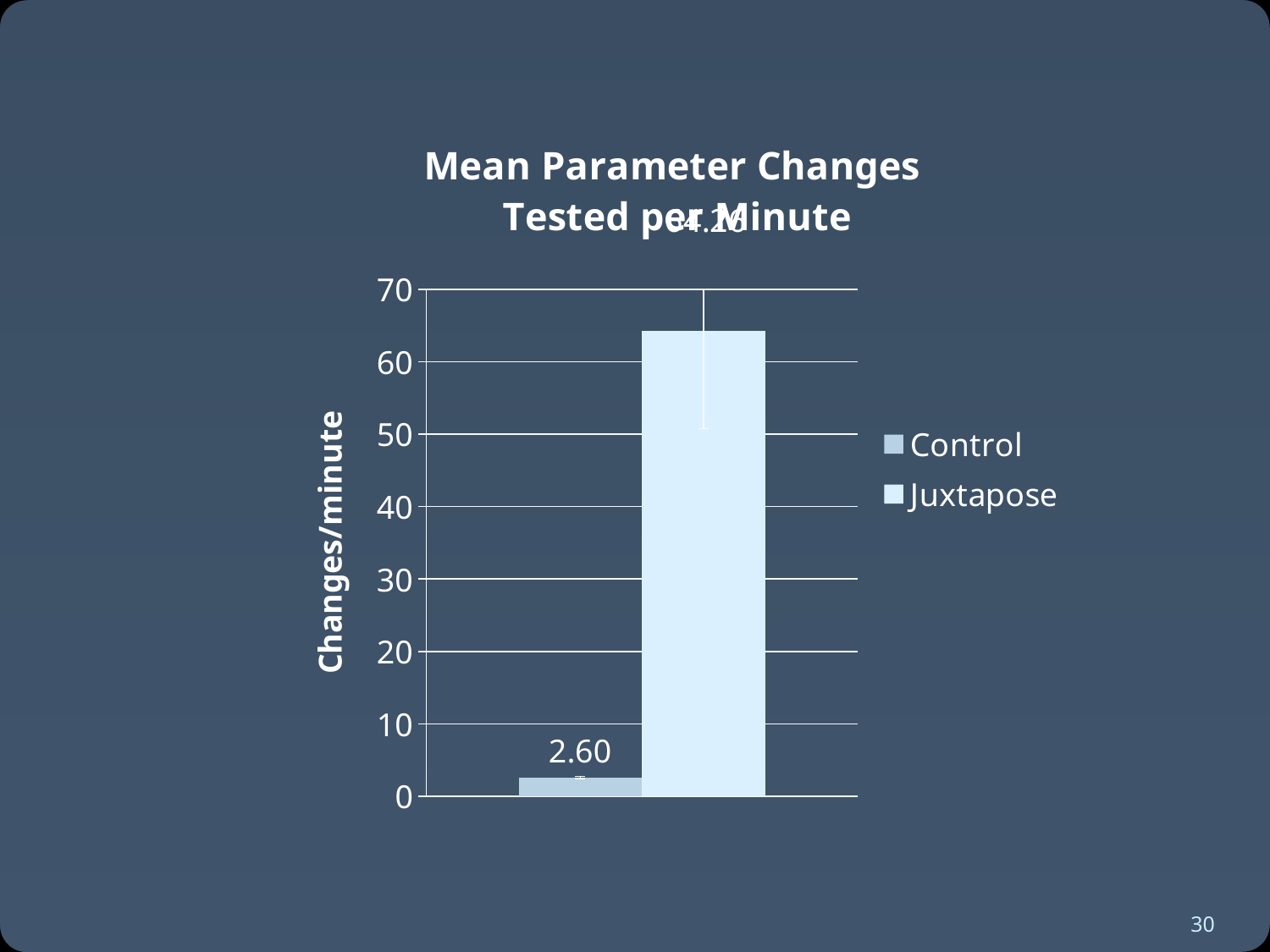
What is the label on the vertical axis of the chart? Changes/minute How many series does the legend list? 2 How many bars are plotted in the chart? 2 Which is larger, the value for Control or the value for Juxtapose? Juxtapose What is the title of the chart? Mean Parameter Changes Tested per Minute What is the value for Control in the Mean Parameter Changes Tested per Minute chart? 2.60 Is the value for Control greater or less than 10? less Which series has the highest value in the chart? Juxtapose What kind of chart is shown on the slide? bar chart Is the value for Juxtapose greater or less than 60? greater Which series has the lowest value in the chart? Control Is the value for Juxtapose greater or less than 70? less